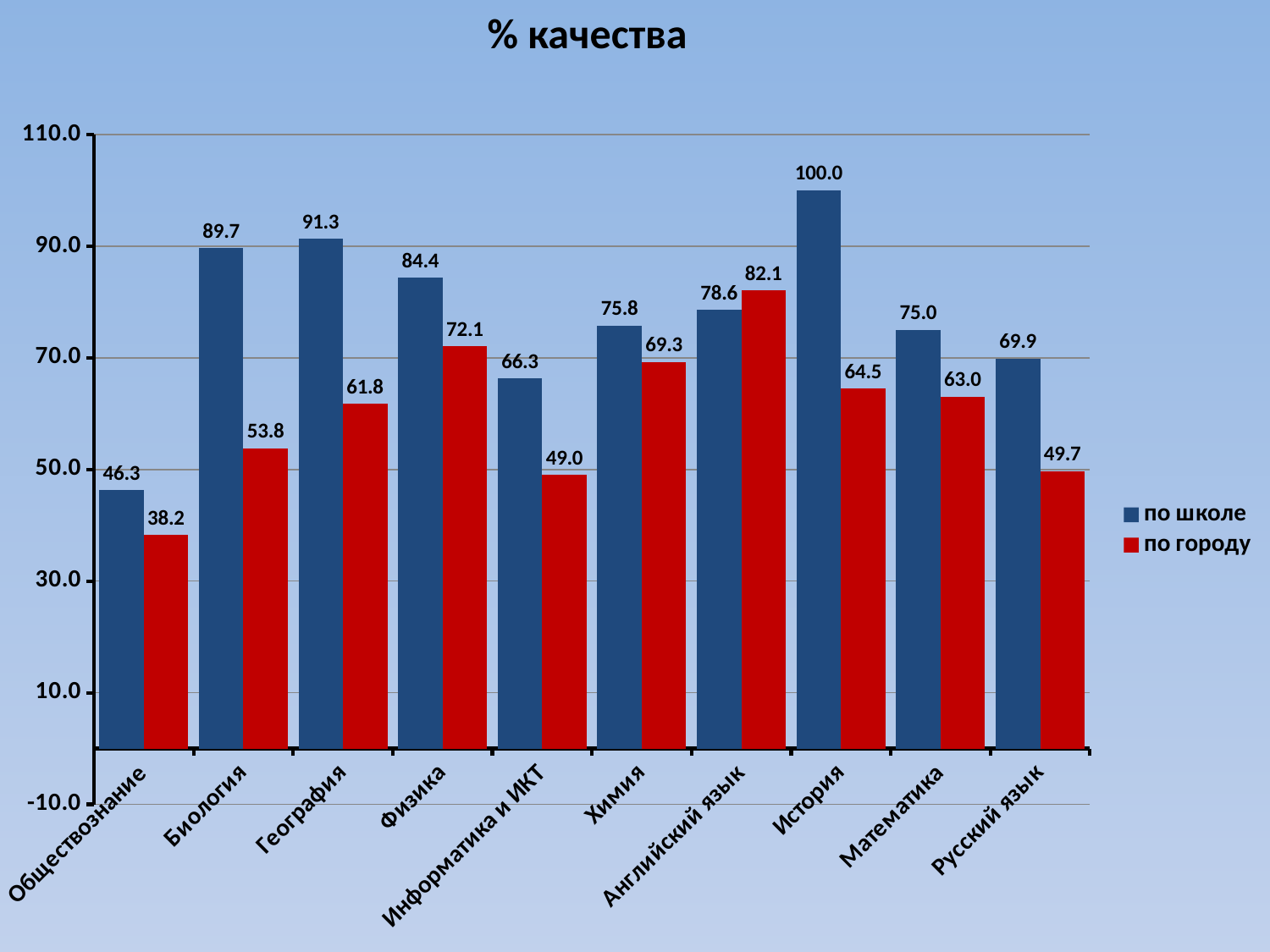
What is the value for "по школе" for История? 100.0 For Английский язык, which is larger: the "по школе" value or the "по городу" value? по городу Is the "по школе" value for Русский язык greater or less than 50.0? greater What is the title of the chart? % качества Which category has the lowest value for "по городу"? Обществознание What is the value for "по городу" for Обществознание? 38.2 What is the difference between the "по школе" and "по городу" values for Биология? 35.9 How many categories are shown on the x axis? 10 What is the value for "по городу" for Физика? 72.1 Which category has the highest value for "по школе"? История What kind of chart is shown on the slide? bar chart How many series does the legend list? 2